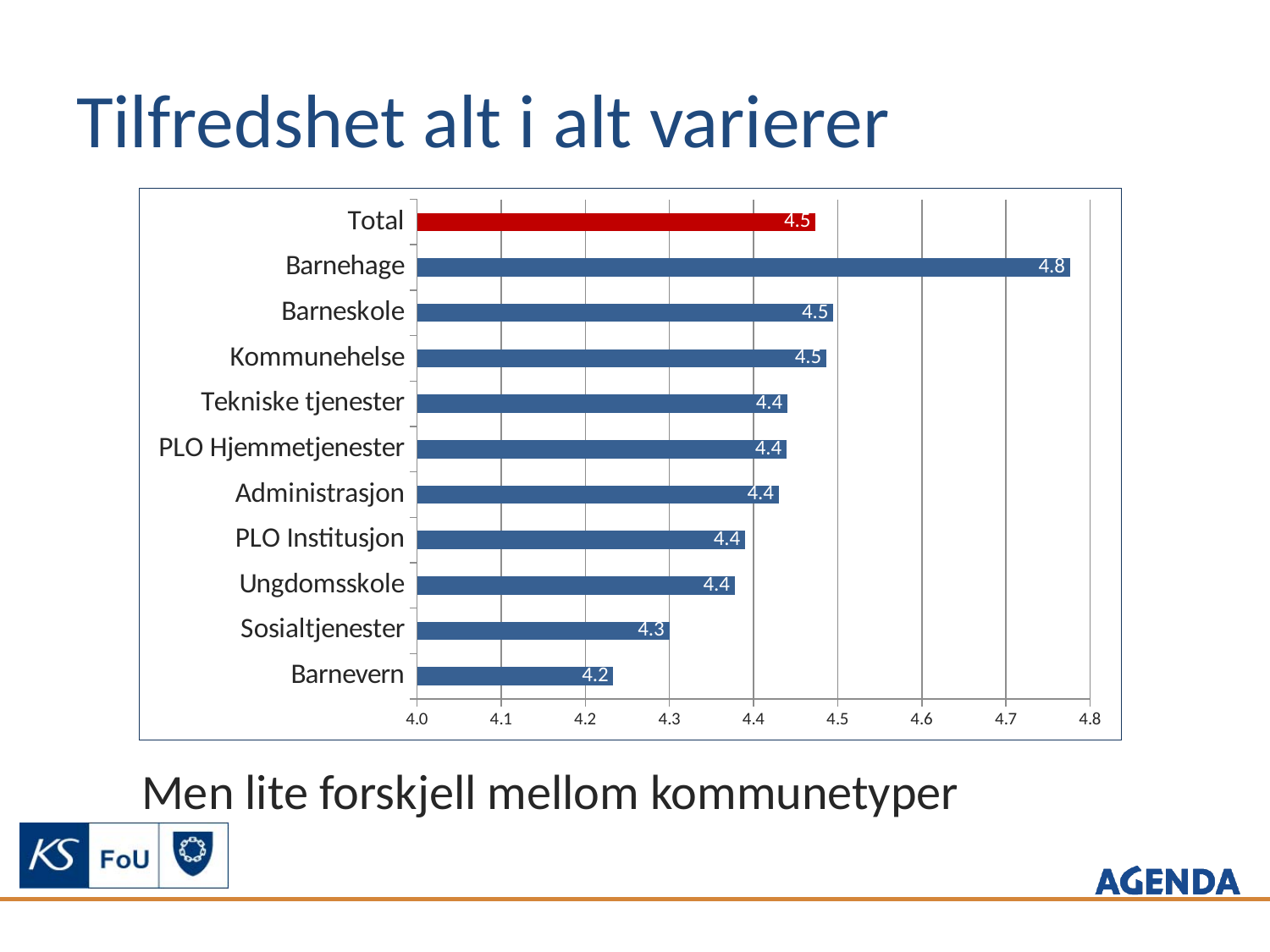
What is the value shown for the Total bar? 4.5 Which category has the lowest value? Barnevern What is the value shown for Barnevern? 4.2 Is the value for Barnevern greater or less than 4.3? less What kind of chart is shown on the slide? Bar chart Which is larger, the value for Barnehage or the value for Sosialtjenester? Barnehage What is the value shown for Barnehage? 4.8 What is the value shown for Sosialtjenester? 4.3 What is the difference between the values for Barnehage and Barnevern? 0.6 How many categories are shown in the chart? 11 Which category has the highest value? Barnehage Which bar is coloured red rather than blue? Total